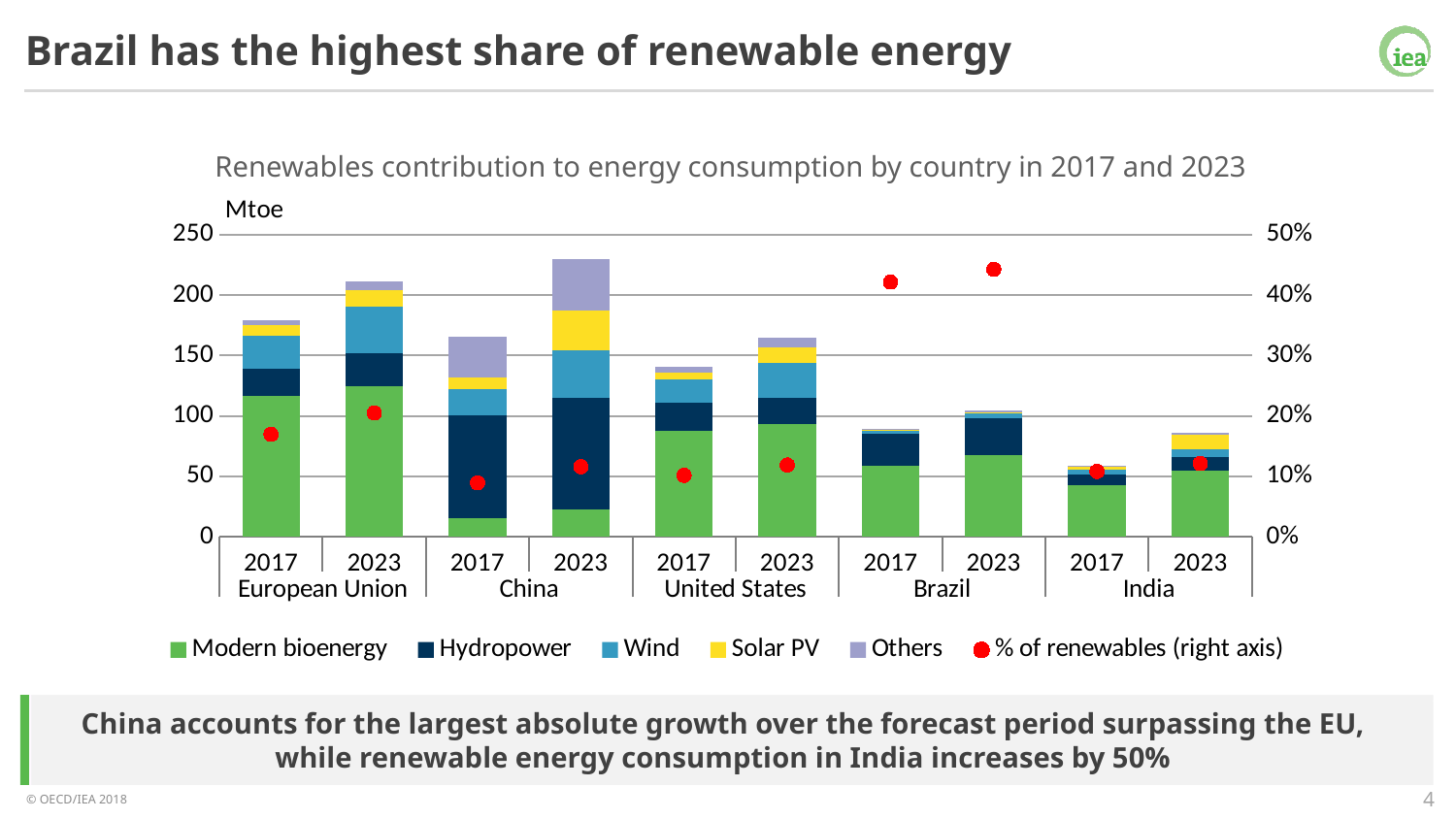
How many entries does the chart legend list? 6 Which country and year has the shortest stacked bar? India 2017 Is the total bar for China in 2023 greater or less than 200 Mtoe? greater What is the title of the chart? Renewables contribution to energy consumption by country in 2017 and 2023 Which country and year has the tallest stacked bar? China 2023 Is the % of renewables for Brazil in 2023 greater or less than 40%? greater Is the % of renewables for the European Union in 2017 greater or less than 20%? less How many countries or regions are shown on the x axis? 5 Which country has the highest % of renewables (red dots)? Brazil What kind of chart is shown on the slide? stacked bar chart Which has the larger total bar in 2023, the European Union or China? China